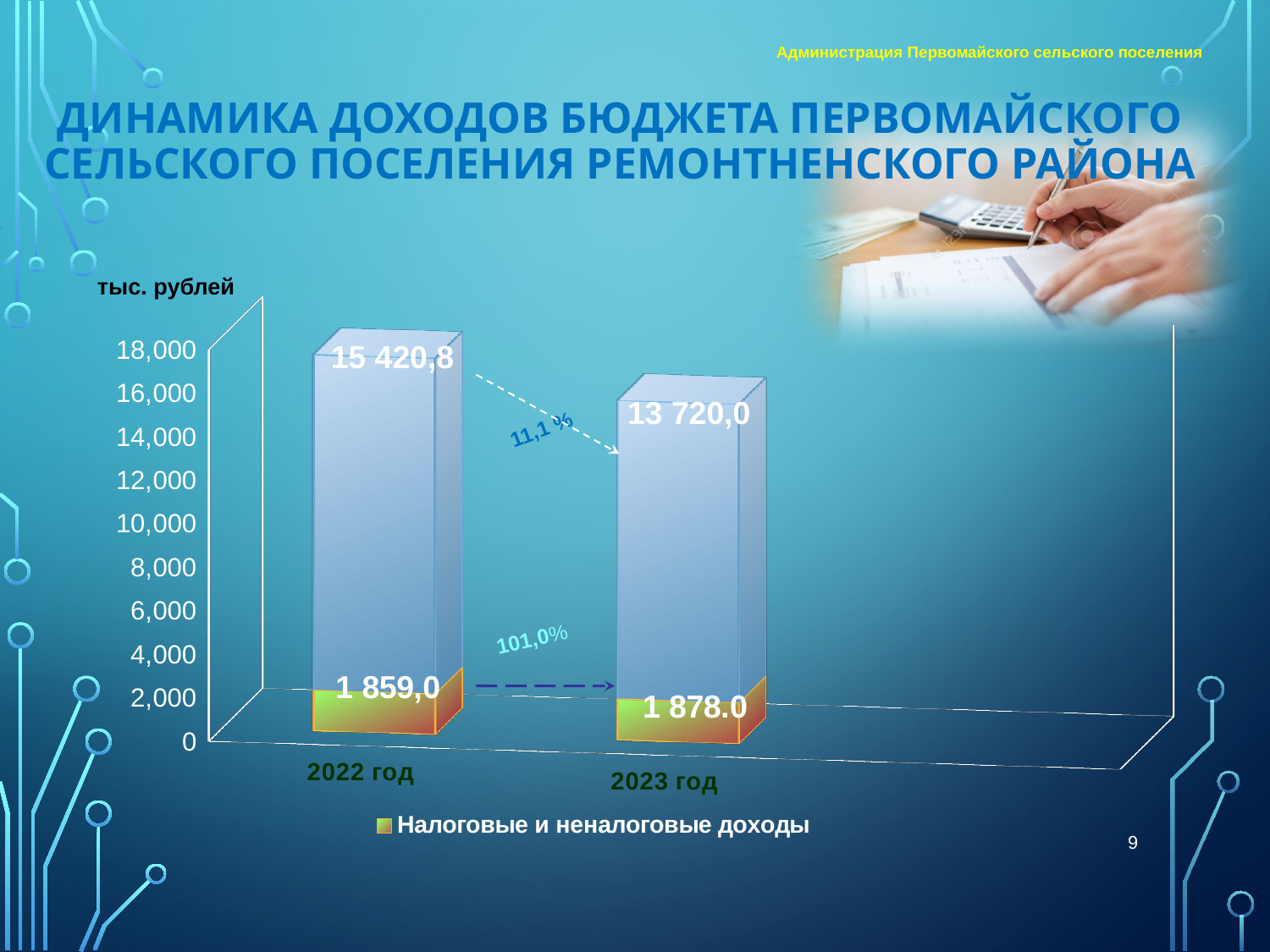
What value is printed on the upper (blue) segment of the 2022 год bar? 15 420,8 Which year has the larger value for Налоговые и неналоговые доходы, 2022 год or 2023 год? 2023 год What is the value of the Налоговые и неналоговые доходы segment for 2023 год? 1 878.0 Does the value of the upper (blue) segment rise or fall from 2022 год to 2023 год? Fall What value is printed on the upper (blue) segment of the 2023 год bar? 13 720,0 What is the difference between the upper (blue) segment values for 2022 год and 2023 год? 1 700,8 What percentage change is annotated between the upper (blue) segments of the 2022 and 2023 bars? 11,1 % Which year has the larger value for the upper (blue) segment, 2022 год or 2023 год? 2022 год What unit is shown above the vertical axis of the chart? тыс. рублей What kind of chart is shown on the slide? Bar chart How many years (categories) are shown on the x axis of the chart? 2 What is the value of the Налоговые и неналоговые доходы segment for 2022 год? 1 859,0